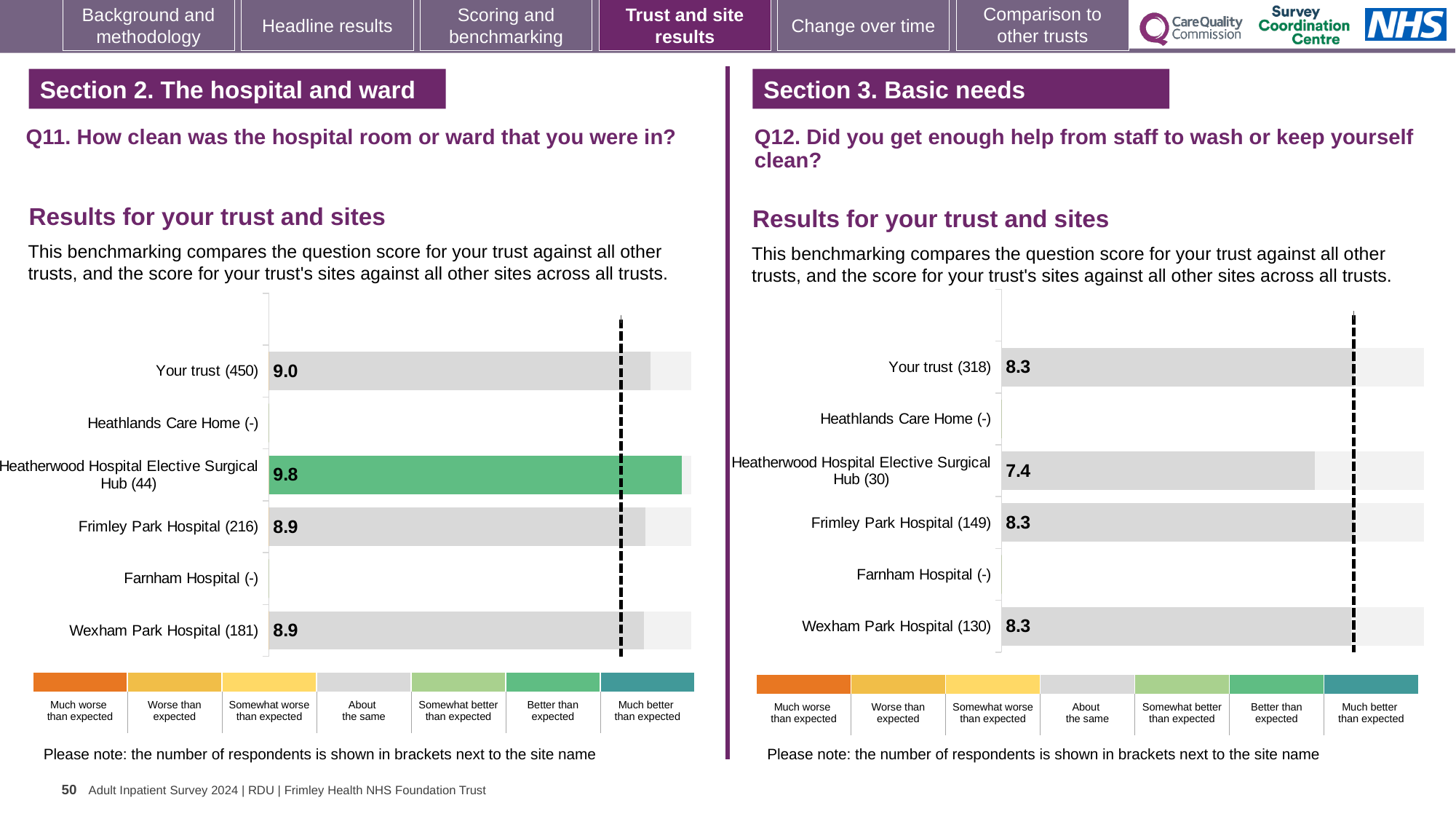
What type of chart is used for the Q11 results on the left? Bar chart In the Q11 chart on the left, what is the score for Heatherwood Hospital Elective Surgical Hub (44)? 9.8 In the Q11 chart on the left, which site's bar is coloured green? Heatherwood Hospital Elective Surgical Hub (44) In the Q12 chart on the right, what is the difference between the scores for Your trust (318) and Heatherwood Hospital Elective Surgical Hub (30)? 0.9 In the Q11 chart on the left, which site has the highest score? Heatherwood Hospital Elective Surgical Hub (44) In the Q12 chart on the right, which site has the lowest score? Heatherwood Hospital Elective Surgical Hub (30) In the Q11 chart on the left, what is the difference between the scores for Heatherwood Hospital Elective Surgical Hub (44) and Frimley Park Hospital (216)? 0.9 In the Q11 chart on the left, what is the score for Your trust (450)? 9.0 In the Q12 chart on the right, what is the score for Heatherwood Hospital Elective Surgical Hub (30)? 7.4 In the Q11 chart on the left, which is larger: the score for Your trust (450) or the score for Wexham Park Hospital (181)? Your trust (450) In the Q12 chart on the right, what is the score for Wexham Park Hospital (130)? 8.3 How many site rows (including Your trust) are listed in the Q12 chart on the right? 6